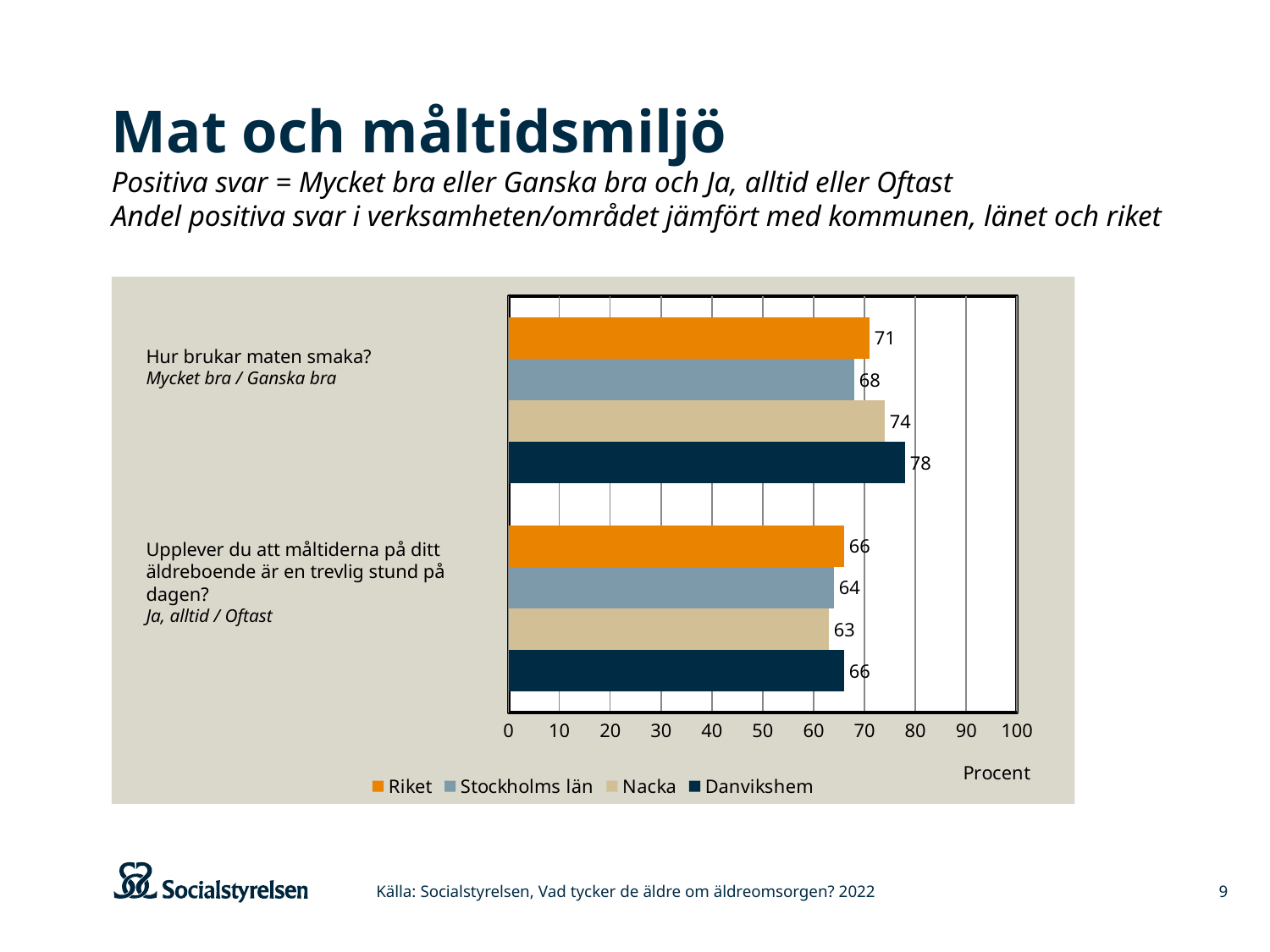
What is the difference between the Danvikshem and Riket values for "Hur brukar maten smaka?"? 7 Which series has the highest value for "Hur brukar maten smaka?"? Danvikshem Which colour represents Riket in the legend? Orange What is the value for Stockholms län on the question "Upplever du att måltiderna på ditt äldreboende är en trevlig stund på dagen?"? 64 What is the value for Danvikshem on the question "Hur brukar maten smaka?"? 78 What is the value for Nacka on the question "Hur brukar maten smaka?"? 74 How many series does the legend list? 4 What kind of chart is shown on the slide? Bar chart Which series has the lowest value for "Upplever du att måltiderna på ditt äldreboende är en trevlig stund på dagen?"? Nacka What unit is shown on the horizontal axis of the chart? Procent For "Upplever du att måltiderna på ditt äldreboende är en trevlig stund på dagen?", which is larger: Riket or Nacka? Riket How many questions (categories) are shown on the chart? 2